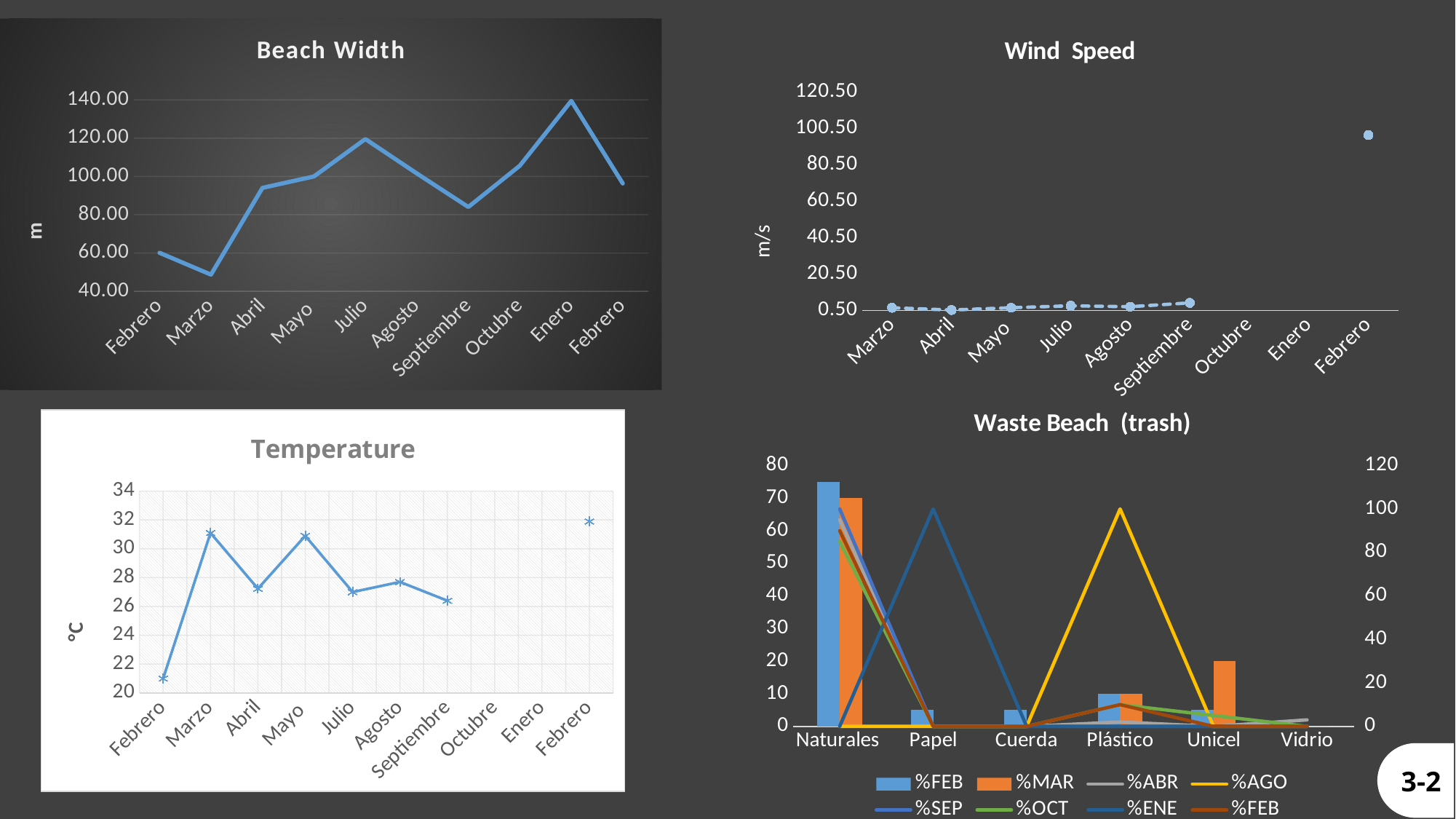
On the Beach Width chart, which month has the highest beach width? Enero On the Beach Width chart, which month has the lowest beach width? Marzo On the Temperature chart, is the value for Septiembre greater or less than 28? less On the Wind Speed chart, which month has the highest wind speed? Febrero On the Waste Beach (trash) chart, which category has the highest %FEB bar? Naturales On the Beach Width chart, how many months are shown on the x axis? 10 On the Wind Speed chart, is the value for Febrero greater or less than 80.50? greater On the Temperature chart, which month has the lowest temperature? Febrero (first) On the Beach Width chart, is the value for Enero greater or less than 120.00? greater On the Waste Beach (trash) chart, how many series does the legend list? 8 On the Temperature chart, which is larger, the value for Marzo or the value for Abril? Marzo